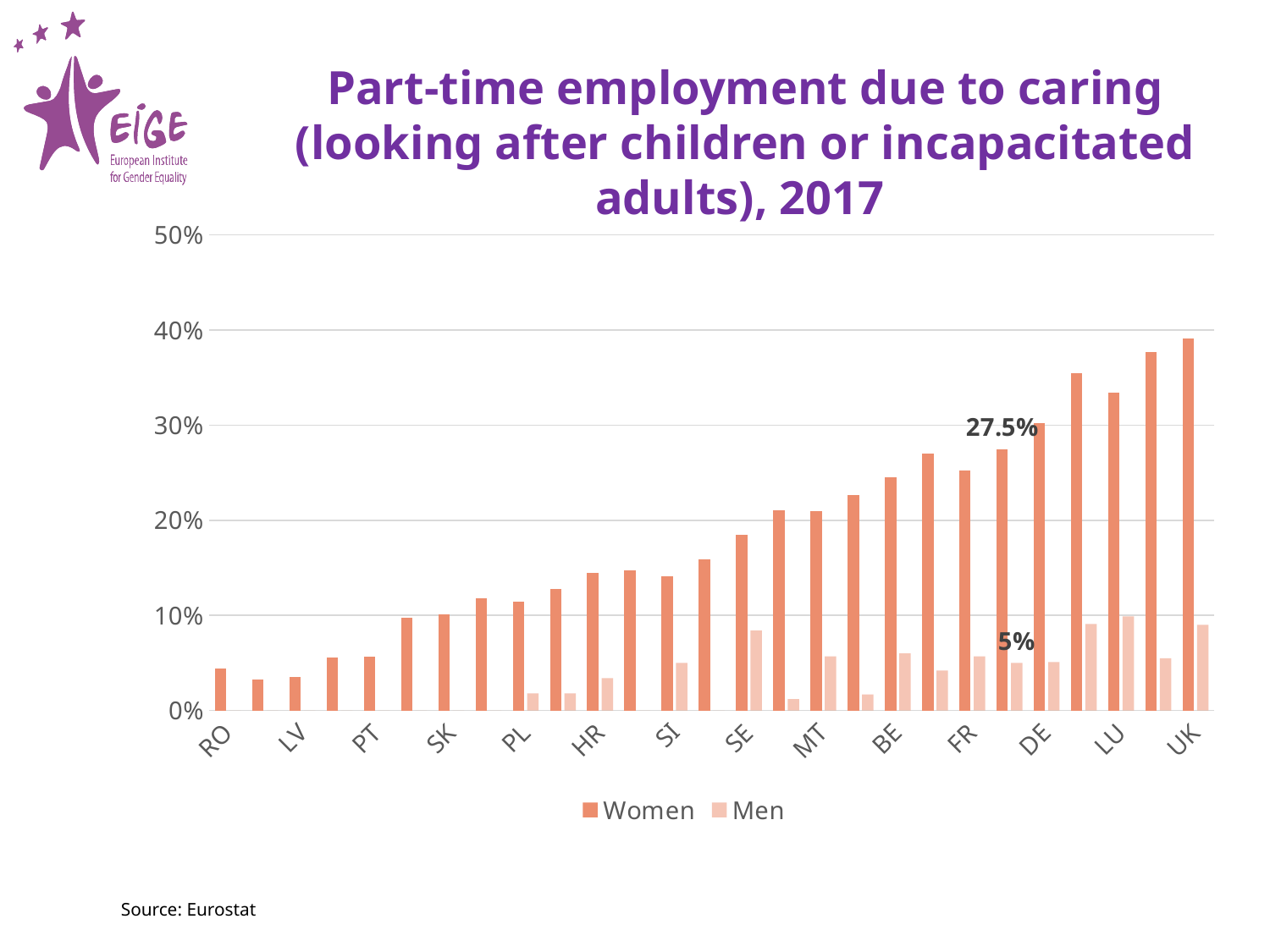
Do the values for Women generally rise or fall from left to right along the x axis? rise Is the value for Women in SE greater or less than 20%? less Which country has the highest value for Women? UK Is the value for Men in LU greater or less than 5%? greater What are the two series named in the legend? Women and Men Is the value for Women in RO greater or less than 10%? less What two data labels are printed on the chart? 27.5% and 5% How many series does the legend list? 2 What kind of chart is shown on the slide? bar chart In the UK, which is larger, the value for Women or the value for Men? Women